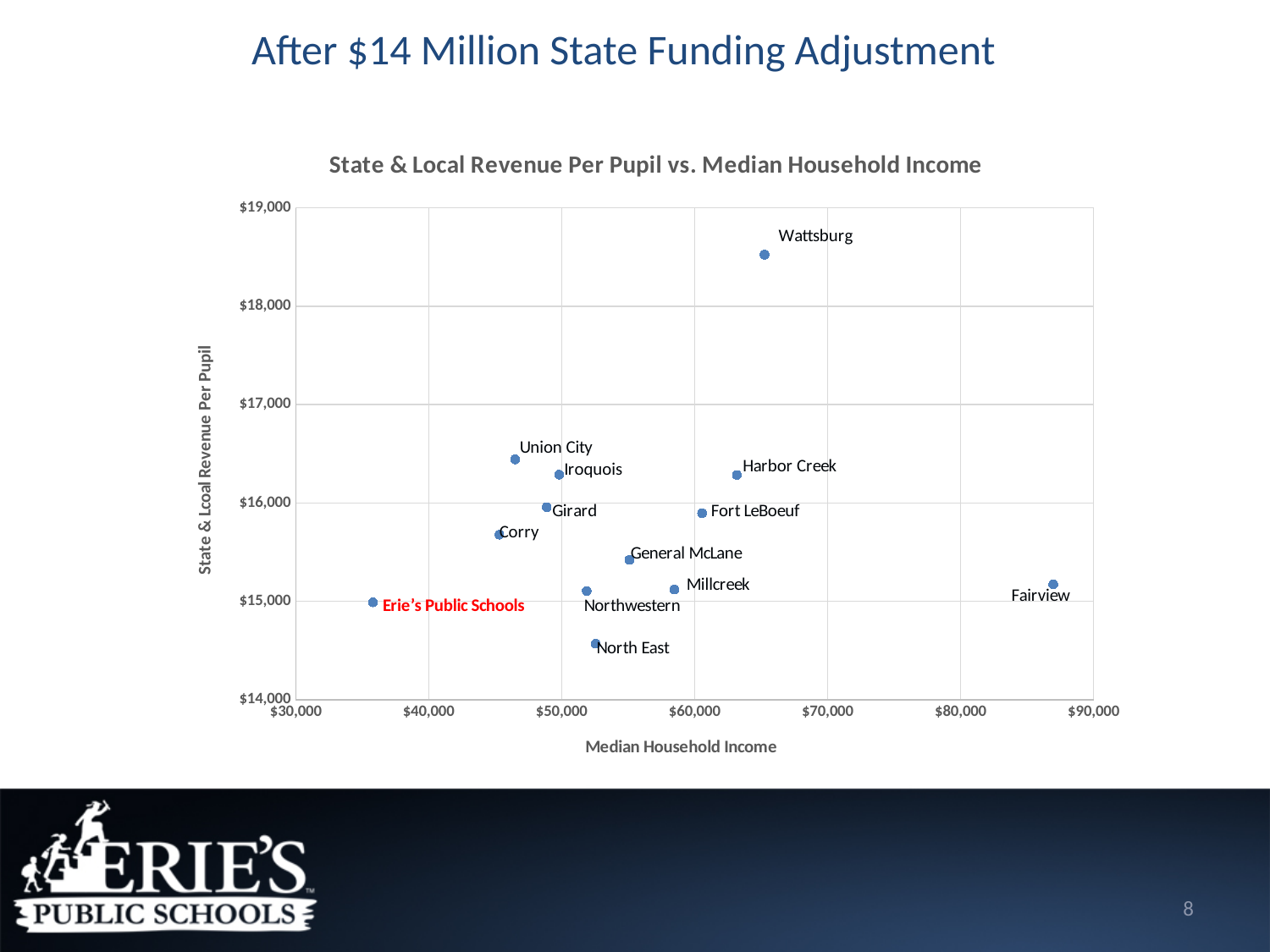
What is the title of the chart? State & Local Revenue Per Pupil vs. Median Household Income Which district has the highest Median Household Income? Fairview Which has the higher Median Household Income, Harbor Creek or Corry? Harbor Creek What kind of chart is shown on the slide? Scatter chart How many school districts are plotted on the chart? 13 Which has the higher State & Local Revenue Per Pupil, Union City or Girard? Union City Is the Median Household Income for Fairview greater or less than $80,000? greater Is the Median Household Income for Erie's Public Schools greater or less than $40,000? less Which district has the lowest Median Household Income? Erie's Public Schools Which district has the highest State & Local Revenue Per Pupil? Wattsburg Which district has the lowest State & Local Revenue Per Pupil? North East Is the State & Local Revenue Per Pupil for Wattsburg greater or less than $18,000? greater